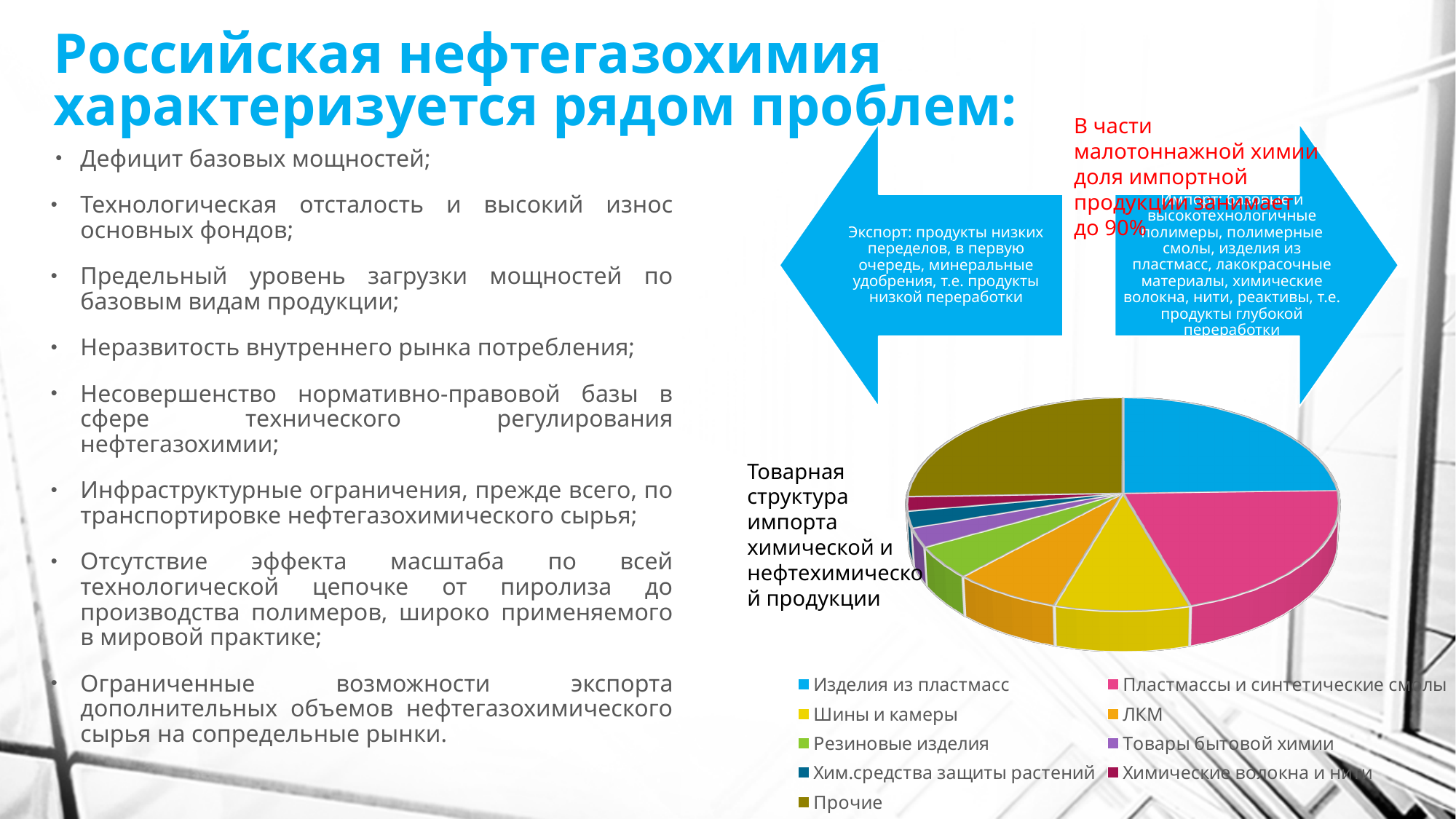
Which category is shown in yellow in the pie chart? Шины и камеры Which is larger in the pie chart: the slice for Прочие or the slice for ЛКМ? Прочие How many categories does the legend of the pie chart list? 9 Which is larger in the pie chart: the slice for Шины и камеры or the slice for Товары бытовой химии? Шины и камеры What kind of chart is shown on the slide? Pie chart Which is larger in the pie chart: the slice for Изделия из пластмасс or the slice for Шины и камеры? Изделия из пластмасс What is the title of the pie chart on the slide? Товарная структура импорта химической и нефтехимической продукции